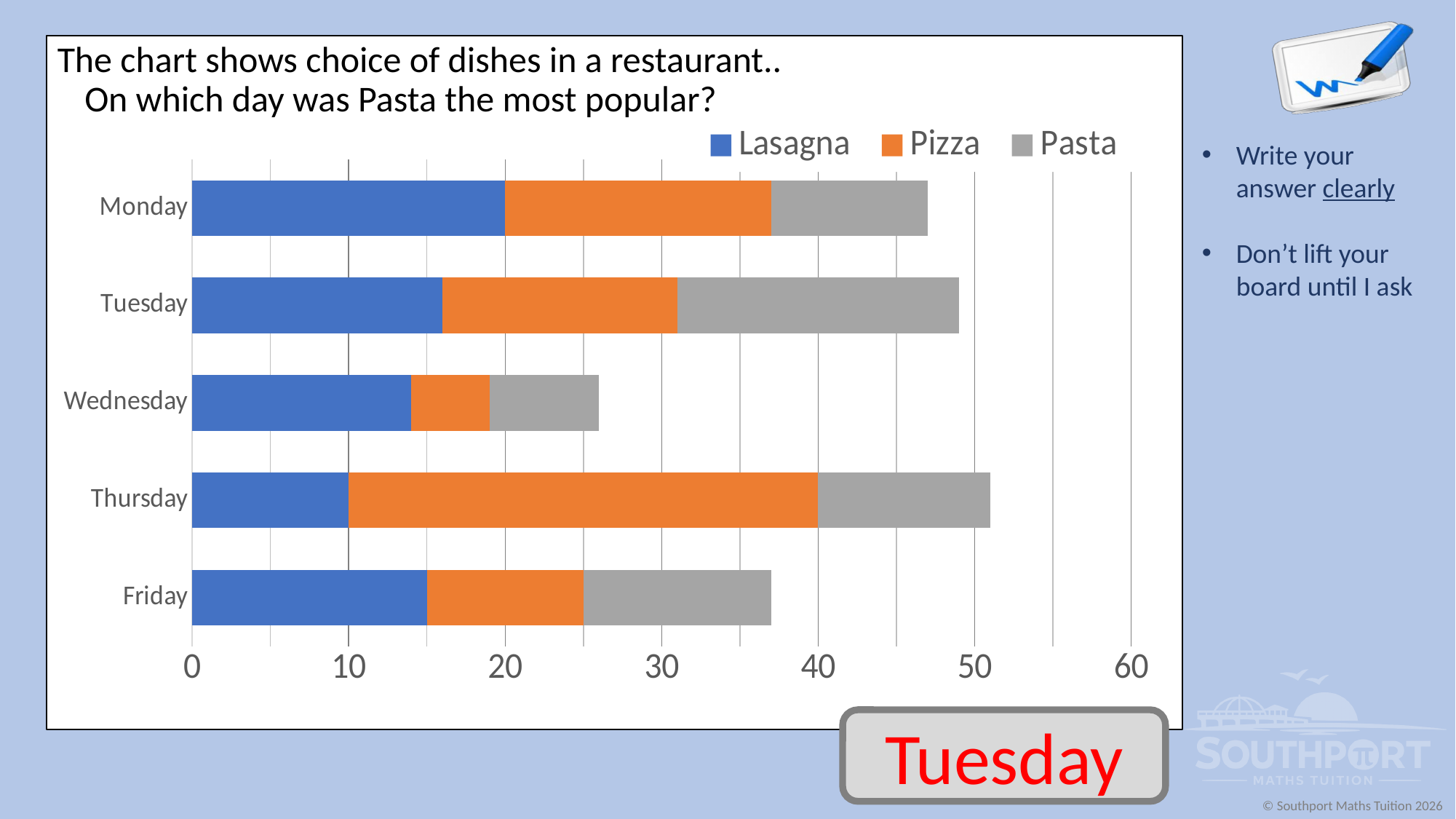
Is the total for Monday greater or less than 40? greater What is the Lasagna value for Thursday? 10 Which colour represents Pasta in the chart? Grey On which day was Pizza the most popular? Thursday On which day was Pasta the most popular? Tuesday Which day has the smallest total number of dishes? Wednesday What is the Lasagna value for Monday? 20 How many series does the legend list? 3 What kind of chart is shown on the slide? Stacked bar chart Is the Lasagna value for Tuesday greater or less than 20? less How many days are shown on the chart? 5 On which day was Lasagna the most popular? Monday